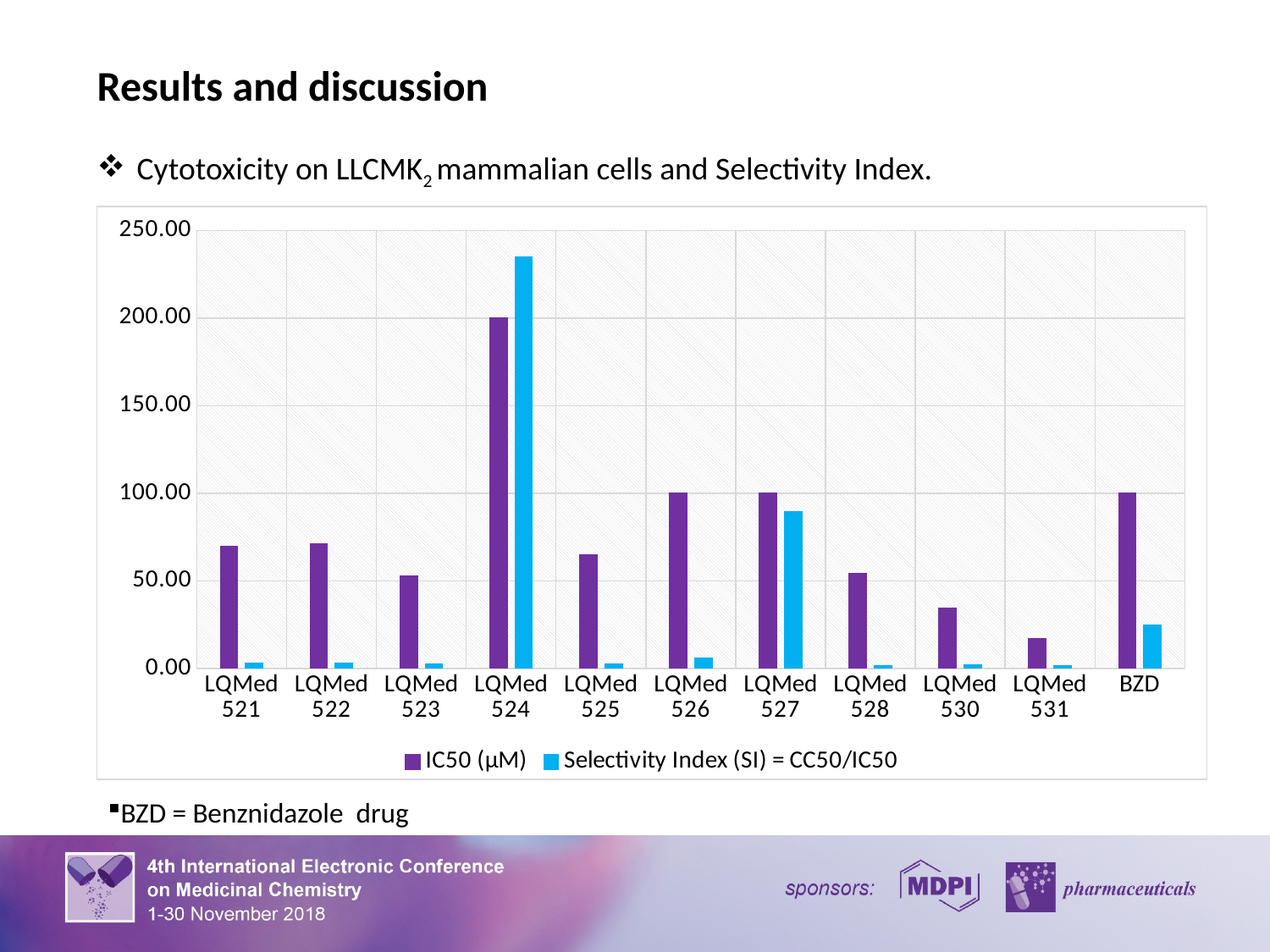
What does the legend say the Selectivity Index (SI) is calculated as? CC50/IC50 Is the IC50 (µM) value for LQMed 530 greater or less than 50? less What kind of chart is shown on the slide? bar chart Is the Selectivity Index (SI) for LQMed 527 greater or less than 50? greater Which has the larger Selectivity Index (SI): LQMed 527 or BZD? LQMed 527 Which compound has the lowest IC50 (µM) value? LQMed 531 How many series does the legend list? 2 Which compound has the highest Selectivity Index (SI)? LQMed 524 Is the IC50 (µM) value for LQMed 521 greater or less than 50? greater How many compounds (categories) are shown on the x axis? 11 Which compound has the highest IC50 (µM) value? LQMed 524 For LQMed 524, which is larger: the IC50 (µM) or the Selectivity Index (SI)? Selectivity Index (SI)